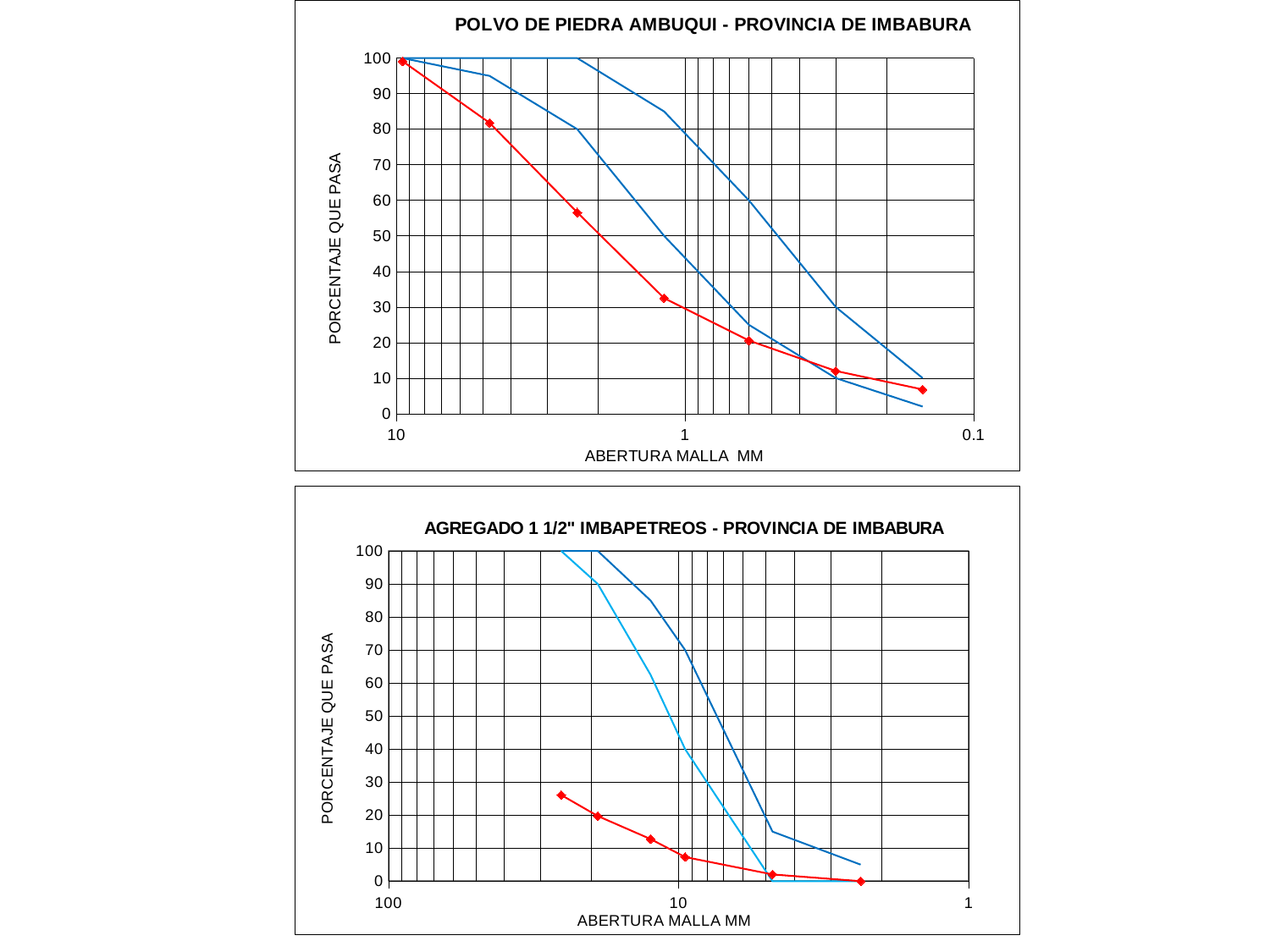
In the top chart, do the values of the red line rise or fall moving from left to right along the x axis? fall In the top chart, is the value of the red line at its third marked point (near 2 mm) greater or less than 50? greater What kind of chart is the bottom chart, 'AGREGADO 1 1/2" IMBAPETREOS - PROVINCIA DE IMBABURA'? line chart In the bottom chart, do the values of the red line rise or fall moving from left to right along the x axis? fall What kind of chart is the top chart, 'POLVO DE PIEDRA AMBUQUI - PROVINCIA DE IMBABURA'? line chart What is the title of the top chart? POLVO DE PIEDRA AMBUQUI - PROVINCIA DE IMBABURA In the bottom chart, is the value of the red line at its first marked point (leftmost) greater or less than 20? greater What is the y-axis label of the bottom chart? PORCENTAJE QUE PASA In the bottom chart, how many lines are plotted? 3 In the top chart, how many lines are plotted? 3 In the bottom chart, how many data points are marked on the red line? 6